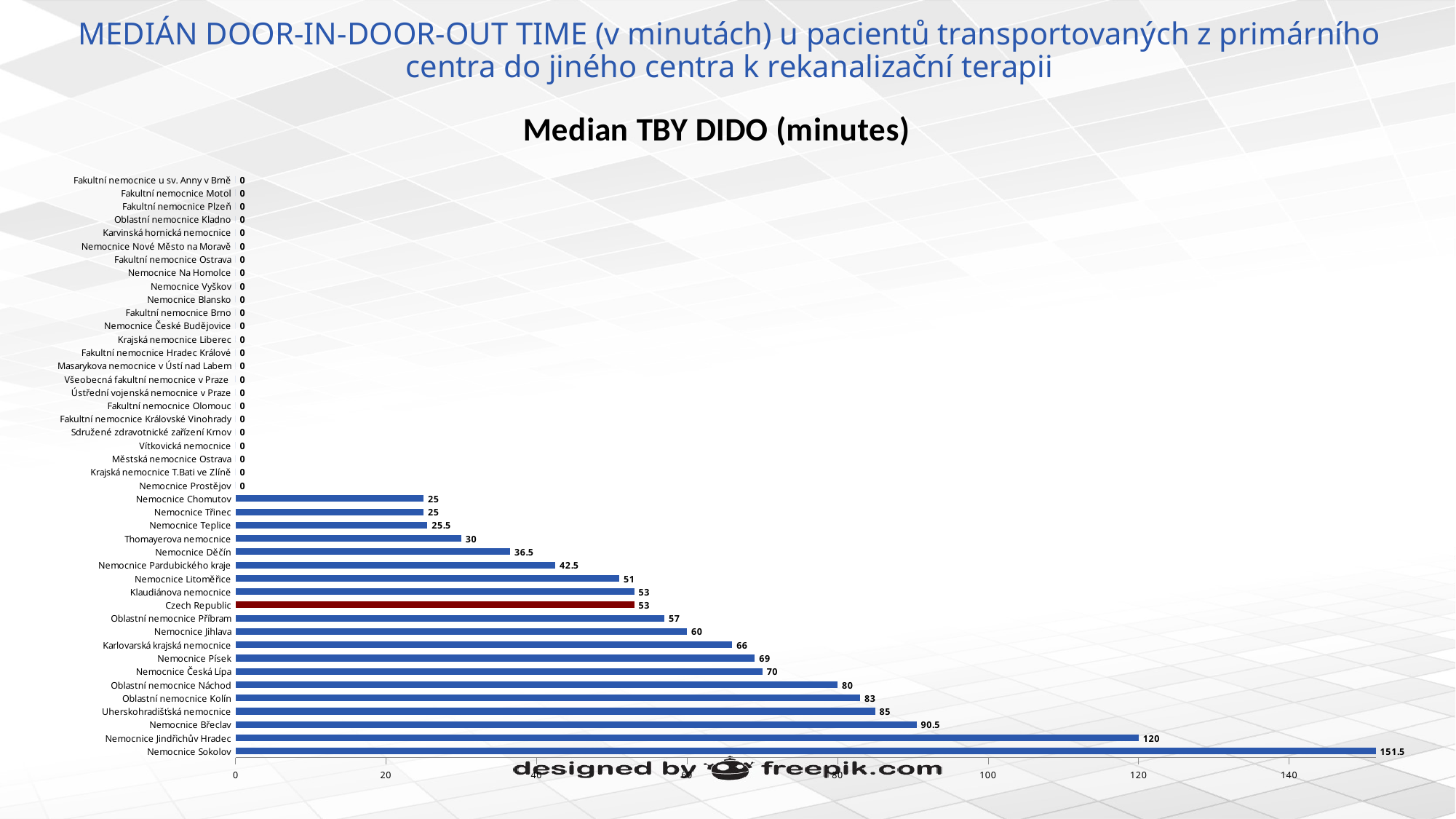
What is the difference between the values for Nemocnice Sokolov and Nemocnice Jindřichův Hradec? 31.5 Which bar is shown in a different colour (dark red) from the others? Czech Republic What is the median TBY DIDO value for Nemocnice Sokolov? 151.5 What is the value for Nemocnice Teplice? 25.5 What is the value shown for Czech Republic? 53 What type of chart is shown on the slide? bar chart Which has a larger value, Oblastní nemocnice Kolín or Oblastní nemocnice Náchod? Oblastní nemocnice Kolín Is the value for Nemocnice Břeclav greater or less than 100? less What is the difference between the values for Nemocnice Břeclav and Czech Republic? 37.5 What is the value for Nemocnice Jindřichův Hradec? 120 Which hospital has the highest median TBY DIDO value? Nemocnice Sokolov How many hospitals have a value greater than 100? 2